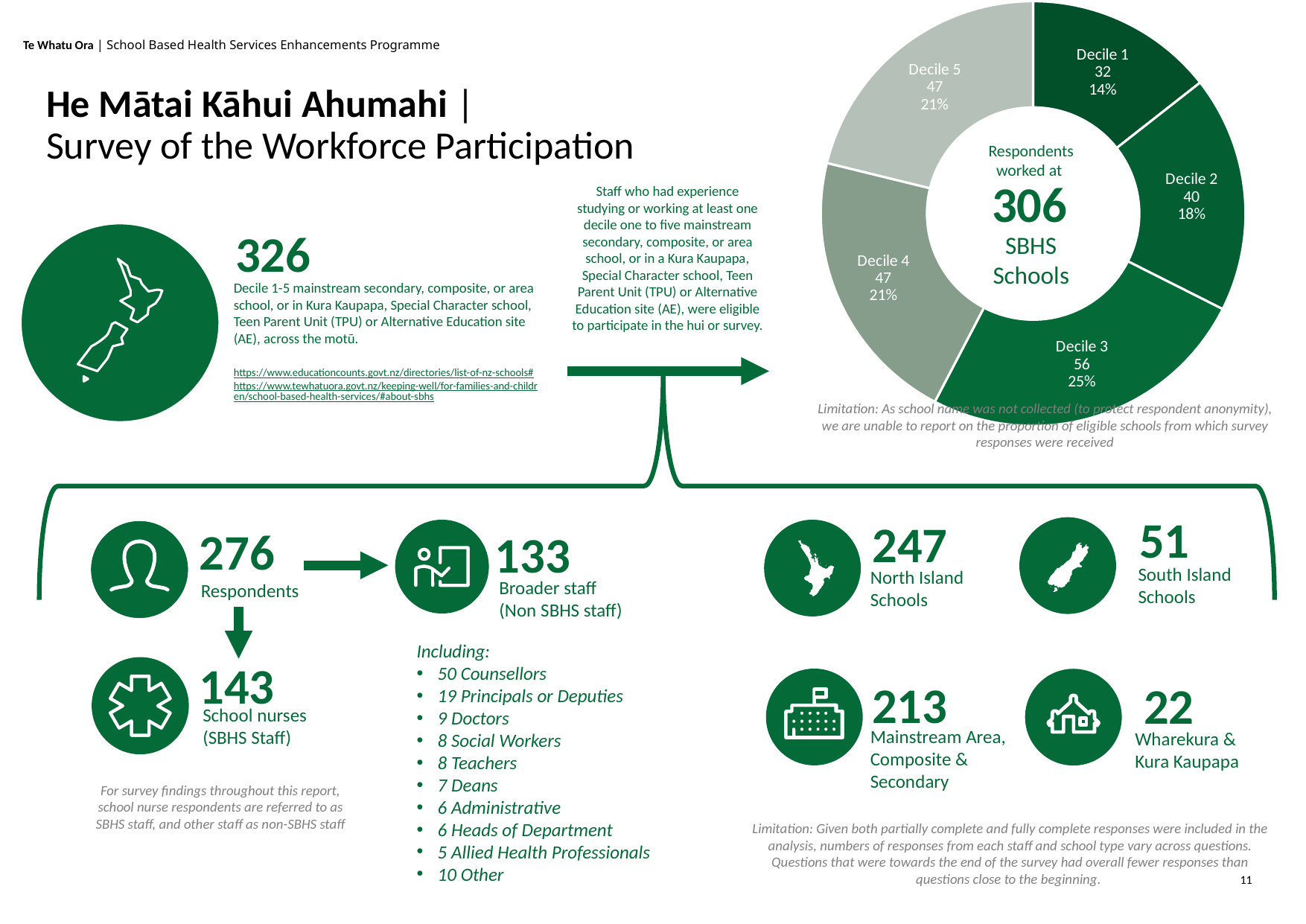
What type of chart is shown on the slide? Donut (pie) chart Which has more schools in the donut chart, Decile 2 or Decile 4? Decile 4 What text appears in the centre of the donut chart? Respondents worked at 306 SBHS Schools What percentage of the donut chart does Decile 5 represent? 21% How many schools in the donut chart are in Decile 1? 32 Which decile has the smallest slice in the donut chart? Decile 1 How many schools in the donut chart are in Decile 3? 56 What percentage of the donut chart does Decile 2 represent? 18% What total number of SBHS schools is shown in the centre of the donut chart? 306 Which decile has the largest slice in the donut chart? Decile 3 What is the difference between the number of Decile 3 schools and Decile 1 schools in the donut chart? 24 How many decile categories are shown in the donut chart? 5